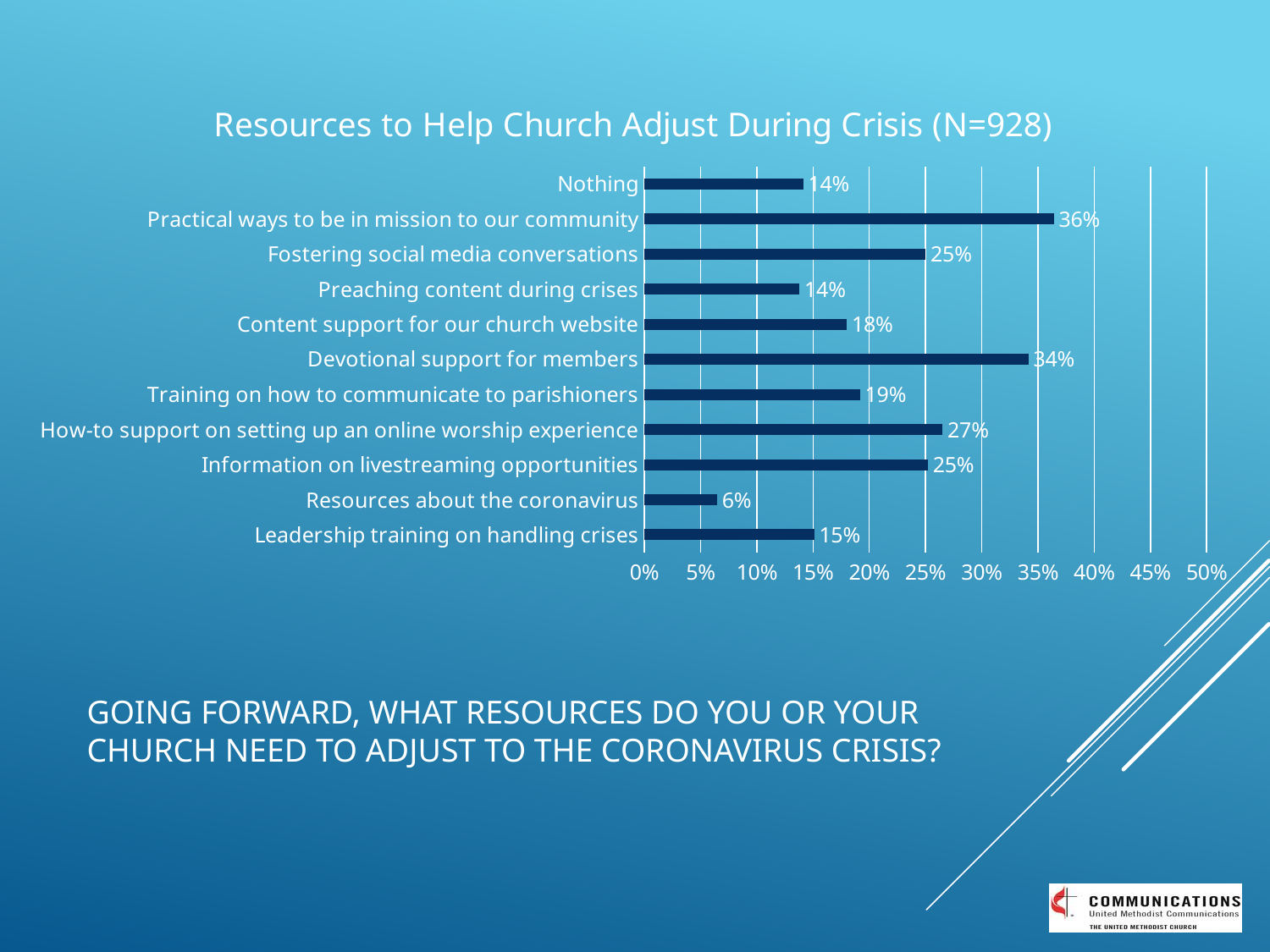
What is the value for "How-to support on setting up an online worship experience"? 27% Is the value for "Training on how to communicate to parishioners" greater or less than 15%? greater What is the difference between "Practical ways to be in mission to our community" and "Devotional support for members"? 2% What is the value for "Devotional support for members"? 34% What is the value for "Practical ways to be in mission to our community"? 36% What kind of chart is shown on the slide? Bar chart Which category has the lowest value? Resources about the coronavirus What is the value for "Resources about the coronavirus"? 6% How many categories are shown in the chart? 11 Which category has the highest value? Practical ways to be in mission to our community What is the title of the chart? Resources to Help Church Adjust During Crisis (N=928) Which is larger: "Fostering social media conversations" or "Content support for our church website"? Fostering social media conversations